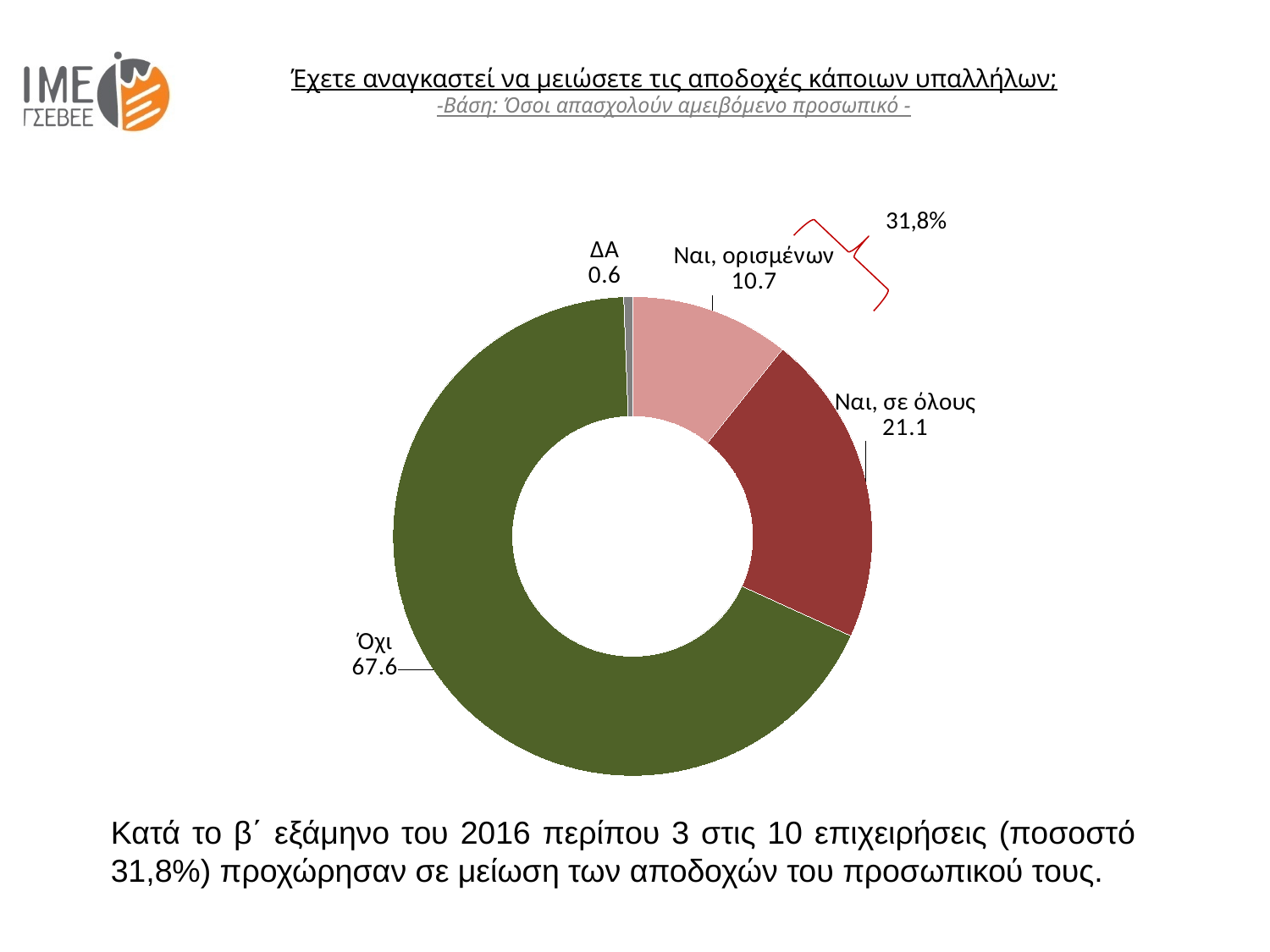
What value is shown for the 'Όχι' slice? 67.6 What kind of chart is shown on the slide? Doughnut (pie) chart What value is shown for the 'Ναι, σε όλους' slice? 21.1 What value is shown for the 'Ναι, ορισμένων' slice? 10.7 What is the difference between the values for 'Ναι, σε όλους' and 'Ναι, ορισμένων'? 10.4 What value is shown for the 'ΔΑ' slice? 0.6 What combined percentage is annotated in red for the two 'Ναι' slices? 31,8% How many categories are shown in the chart? 4 Which is larger, the value for 'Ναι, σε όλους' or for 'Ναι, ορισμένων'? Ναι, σε όλους What is the difference between the values for 'Όχι' and 'Ναι, σε όλους'? 46.5 Which category has the largest slice? Όχι Which category has the smallest slice? ΔΑ